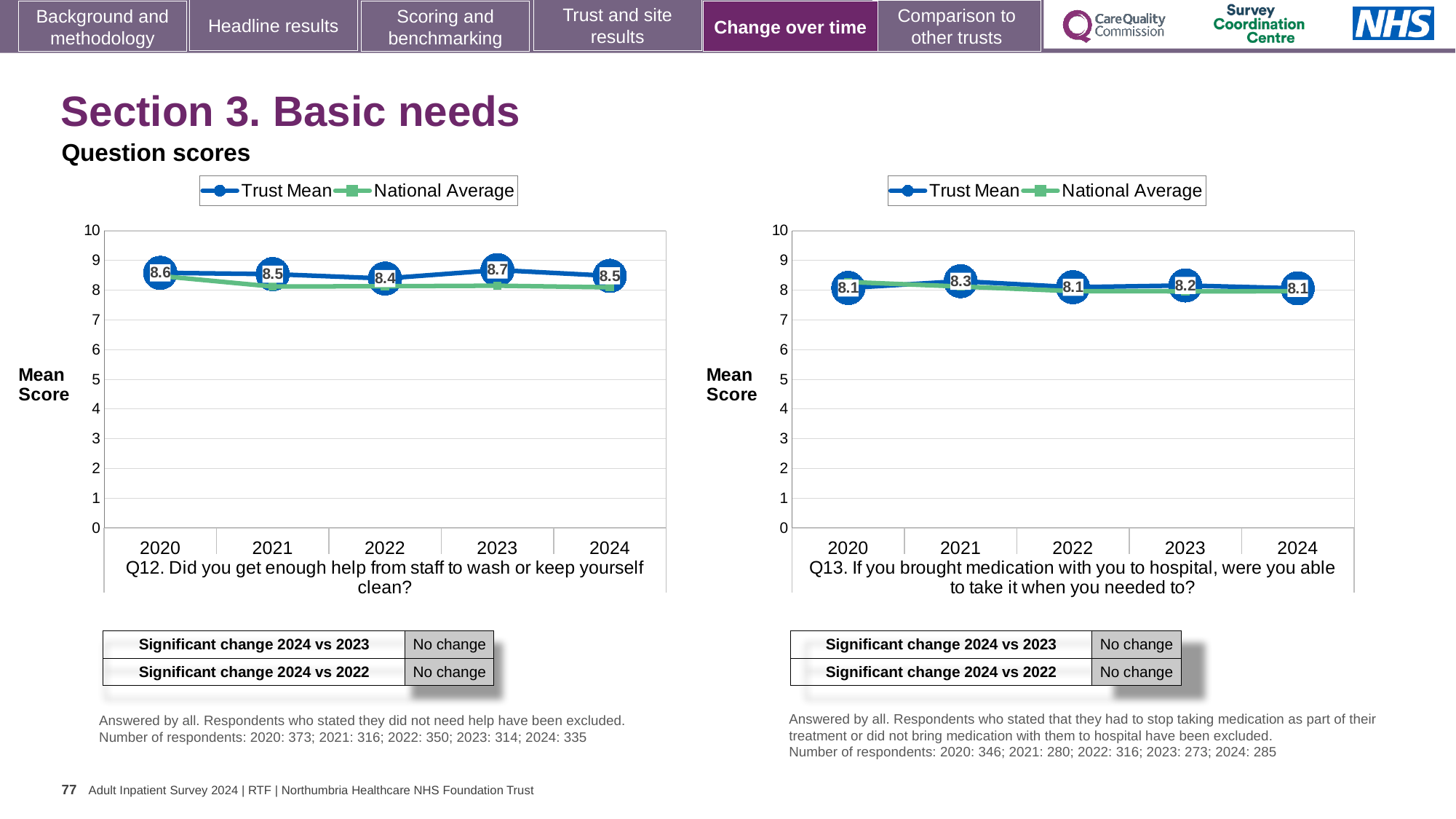
In the Q12 chart on the left, what is the Trust Mean score for 2020? 8.6 In the Q12 chart on the left, what is the Trust Mean score for 2023? 8.7 In the Q12 chart on the left, is the Trust Mean score for 2020 or 2022 larger? 2020 How many series does the legend of the Q13 chart on the right list? 2 In the Q12 chart on the left, which year has the lowest Trust Mean score? 2022 In the Q12 chart on the left, what is the difference between the Trust Mean scores for 2023 and 2022? 0.3 In the Q13 chart on the right, what is the Trust Mean score for 2024? 8.1 In the Q13 chart on the right, what is the difference between the Trust Mean scores for 2021 and 2020? 0.2 In the Q13 chart on the right, which year has the highest Trust Mean score? 2021 In the Q12 chart on the left, which year has the highest Trust Mean score? 2023 In the Q13 chart on the right, what is the Trust Mean score for 2021? 8.3 What kind of chart is the Q12 chart on the left? Line chart